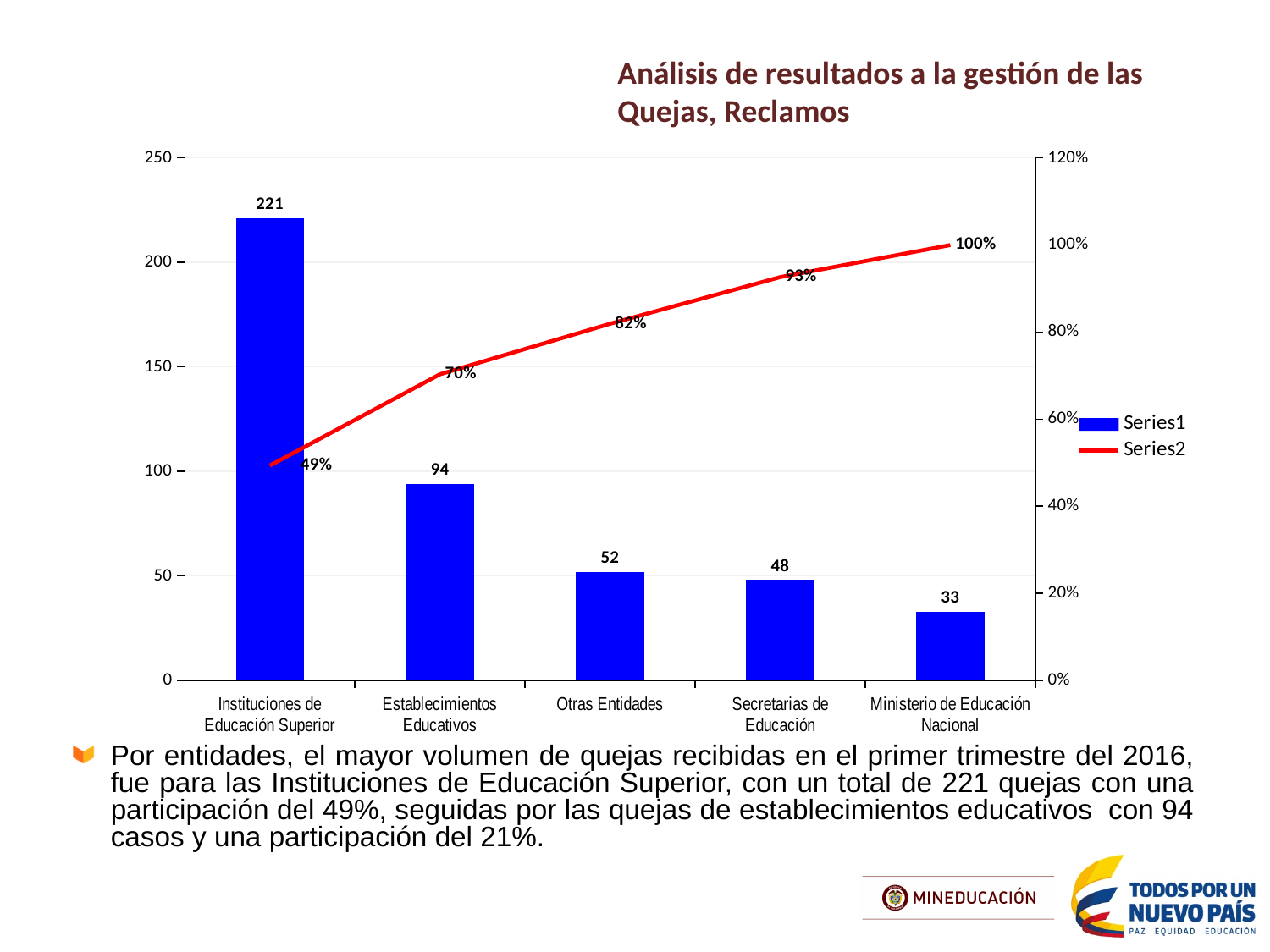
How many categories are shown on the x axis? 5 Which category has the highest Series1 value? Instituciones de Educación Superior What colour is the Series2 line? red What is the Series1 value for Otras Entidades? 52 Which category has the lowest Series1 value? Ministerio de Educación Nacional Which has a larger Series1 value, Otras Entidades or Secretarias de Educación? Otras Entidades Does the Series2 line rise or fall from left to right across the categories? rise What is the difference between the Series1 values for Instituciones de Educación Superior and Establecimientos Educativos? 127 How many series does the legend list? 2 What is the Series1 value for Instituciones de Educación Superior? 221 What is the Series2 value for Establecimientos Educativos? 70% What is the Series2 value for Ministerio de Educación Nacional? 100%